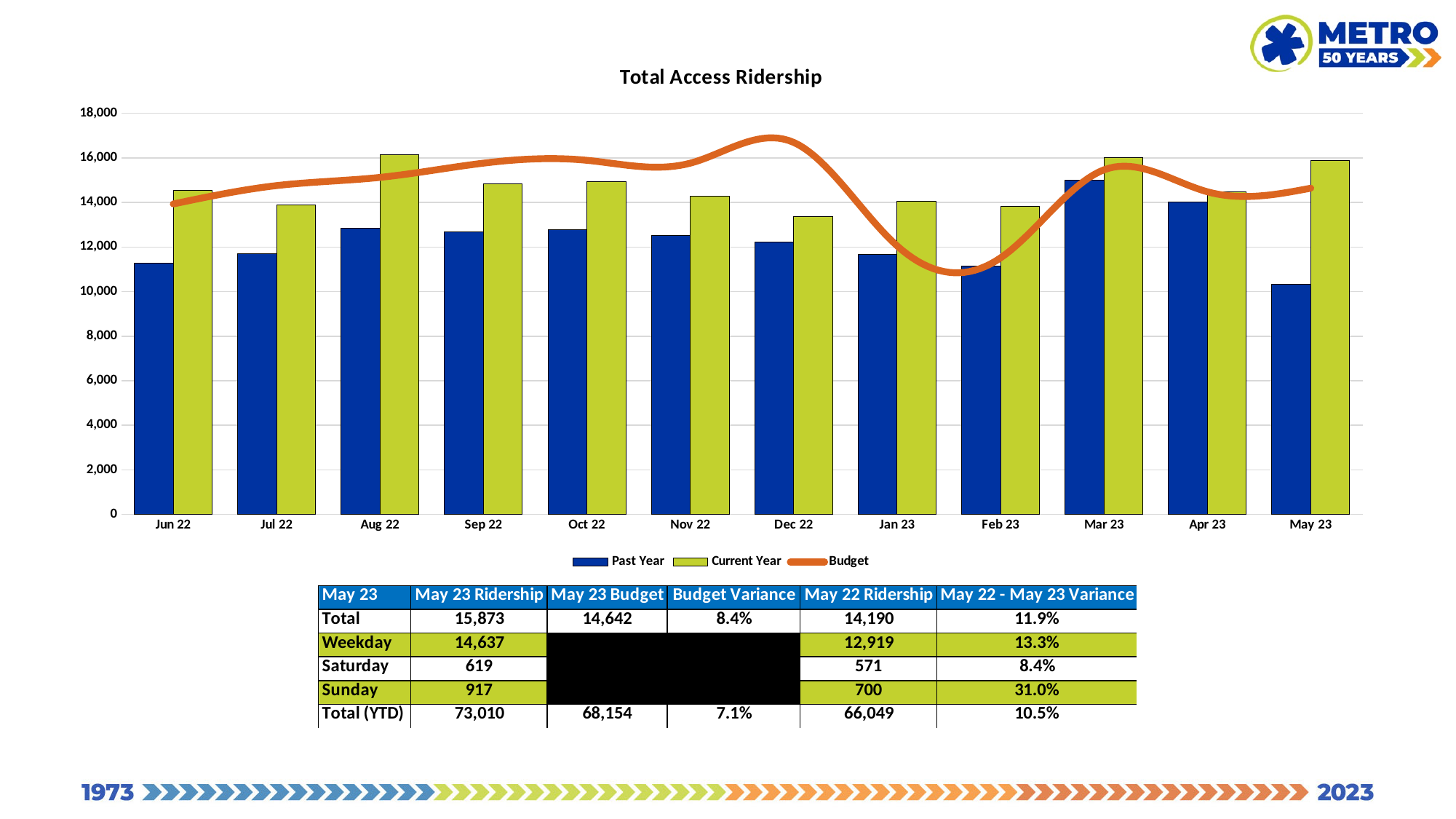
Which month has the highest Past Year bar? Mar 23 What is the title of the chart? Total Access Ridership How many months are shown on the x axis of the chart? 12 How many series does the chart legend list? 3 Which month has the lowest Past Year bar? May 23 In Jan 23, which is larger: the Past Year bar or the Current Year bar? Current Year Is the Current Year value for Dec 22 greater or less than 14,000? less What kind of chart is shown on the slide? bar chart with a line Is the Past Year value for May 23 greater or less than 12,000? less Is the Past Year value for Jun 22 greater or less than 12,000? less What colour is the Budget line in the chart? orange